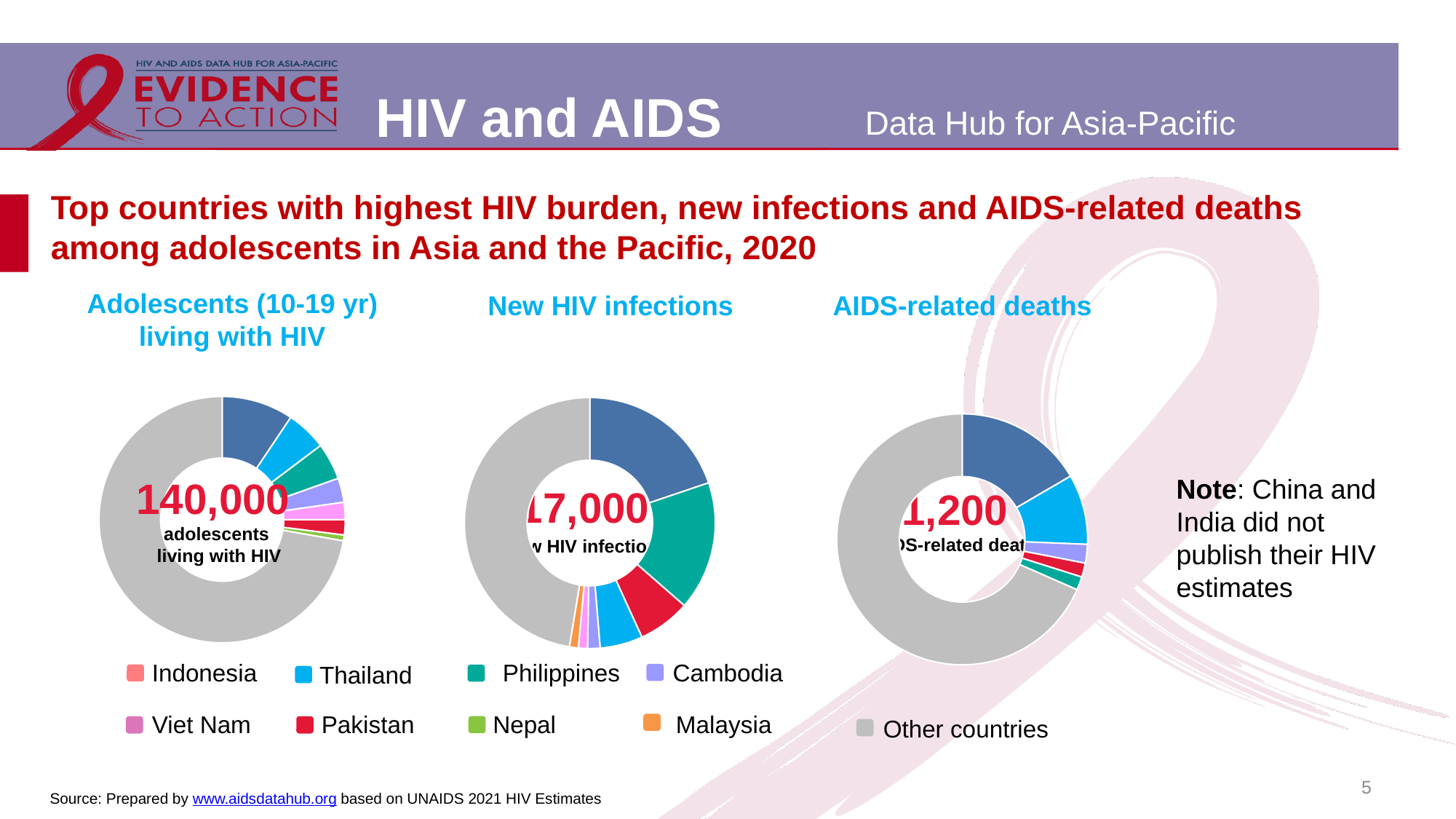
In the 'AIDS-related deaths' chart, what total number is printed in the centre? 1,200 In the 'AIDS-related deaths' chart, which slice is larger: Thailand or Pakistan? Thailand In the 'Adolescents (10-19 yr) living with HIV' chart, what total number is printed in the centre? 140,000 How many charts are shown on the slide? 3 In the 'Adolescents (10-19 yr) living with HIV' chart, which legend category has the largest slice? Other countries Which is larger: the total for adolescents living with HIV or the total for new HIV infections? Adolescents living with HIV What is the difference between the total adolescents living with HIV (140,000) and the total new HIV infections (17,000)? 123,000 How many entries does the shared legend below the charts list? 9 What colour represents 'Other countries' in the legend? Grey In the 'New HIV infections' chart, what total number is printed in the centre? 17,000 What is the difference between the total new HIV infections (17,000) and the total AIDS-related deaths (1,200)? 15,800 What kind of chart is used for the three charts on the slide? Pie (donut) chart